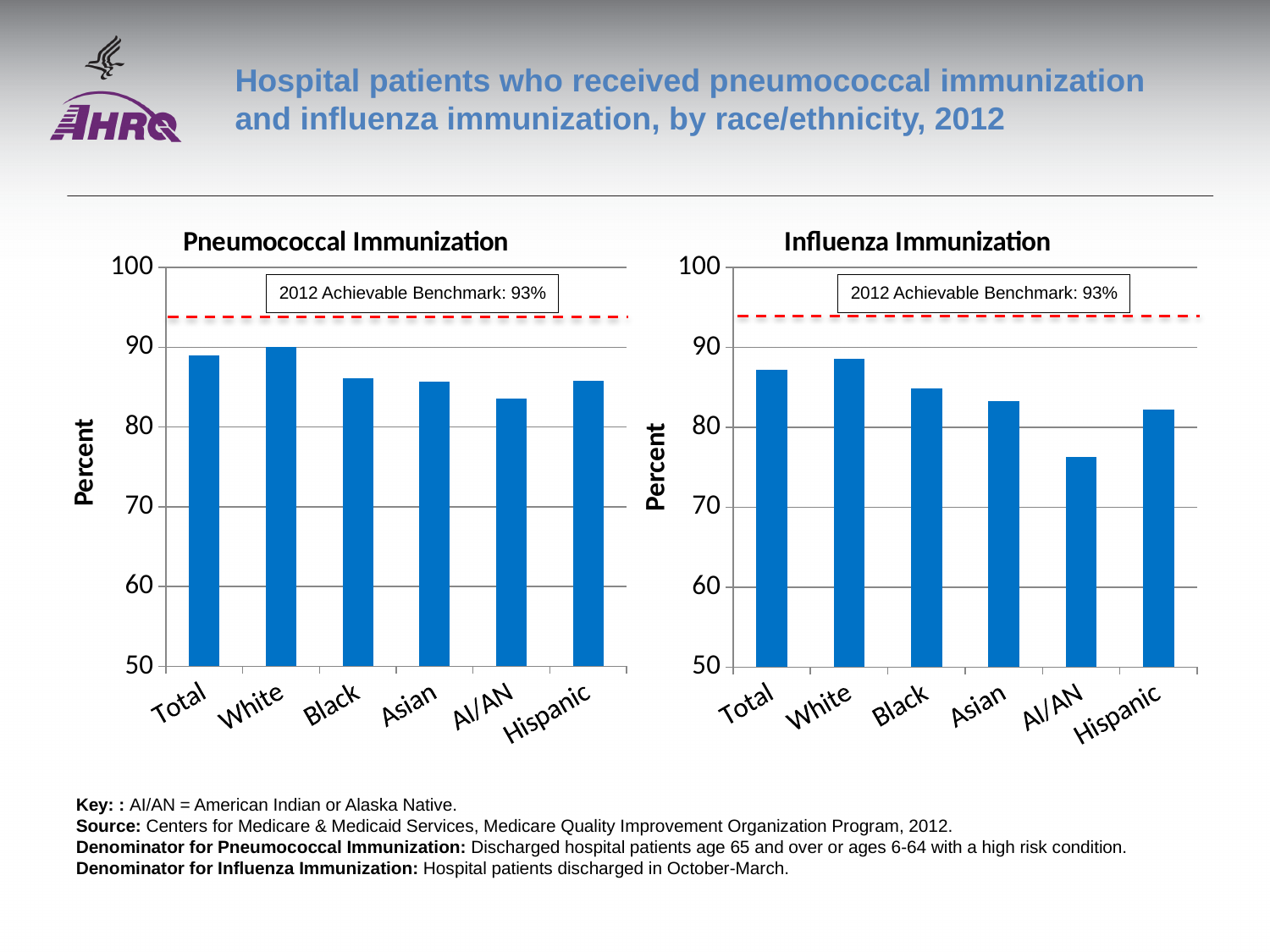
On the Influenza Immunization chart, which category has the highest value? White What kind of chart is the Pneumococcal Immunization chart? bar chart On the Influenza Immunization chart, which category has the lowest value? AI/AN On the Pneumococcal Immunization chart, which category has the lowest value? AI/AN On the Influenza Immunization chart, which is larger, the value for Black or the value for AI/AN? Black What is the y-axis label on the Pneumococcal Immunization chart? Percent What is the 2012 Achievable Benchmark shown on the Influenza Immunization chart? 93% On the Influenza Immunization chart, is the value for AI/AN greater or less than 80? less On the Pneumococcal Immunization chart, is the value for AI/AN greater or less than 80? greater On the Pneumococcal Immunization chart, which is larger, the value for Total or the value for AI/AN? Total On the Pneumococcal Immunization chart, is the value for Black greater or less than 90? less How many race/ethnicity categories are shown on the Influenza Immunization chart? 6